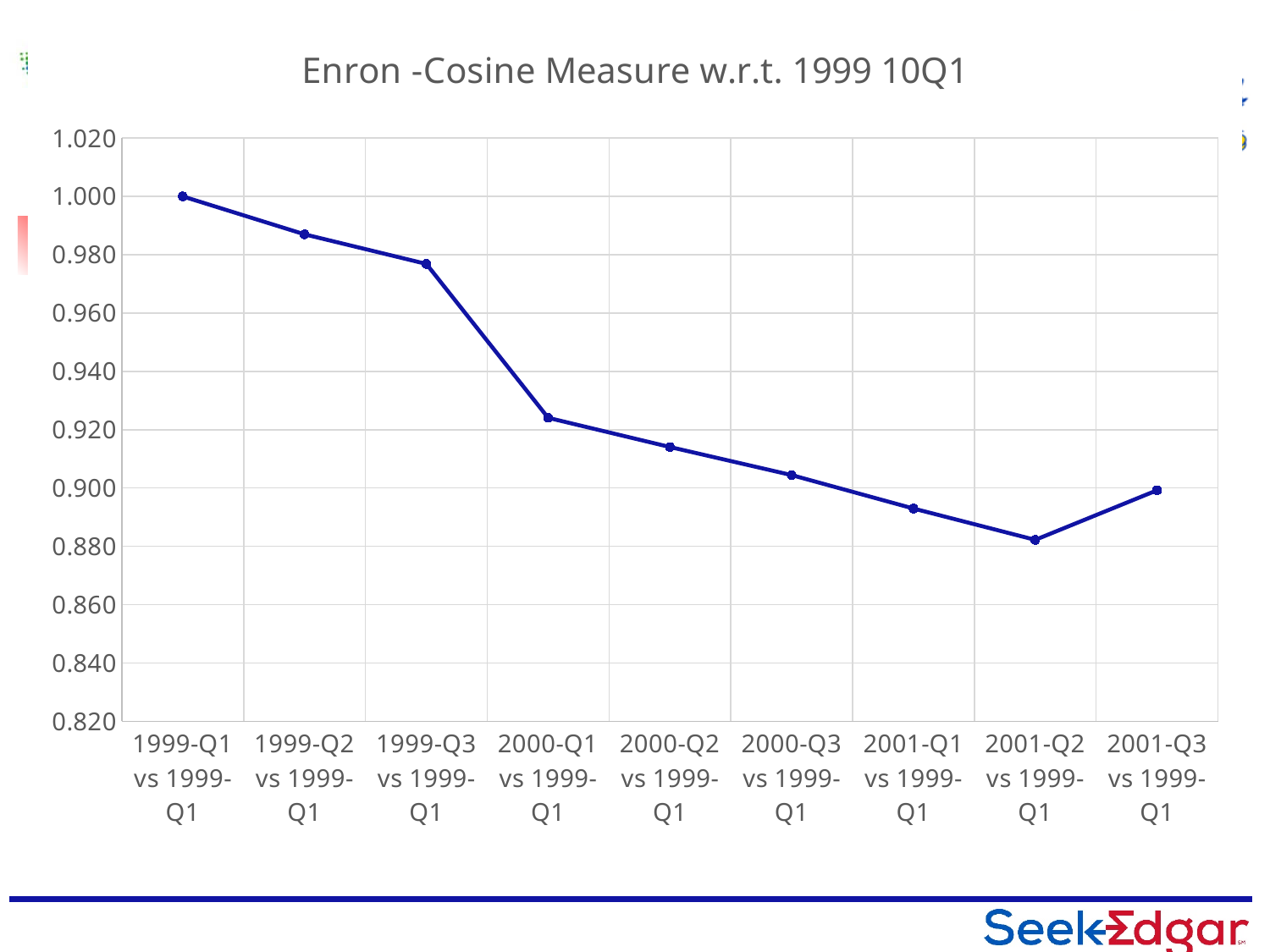
Which category has the lowest value? 2001-Q2 vs 1999-Q1 Is the value for 2000-Q1 vs 1999-Q1 greater or less than 0.940? less Is the value for 1999-Q2 vs 1999-Q1 greater or less than 0.980? greater Is the value for 2000-Q2 vs 1999-Q1 greater or less than 0.920? less What is the title of the chart? Enron -Cosine Measure w.r.t. 1999 10Q1 Do the values generally rise or fall from 1999-Q1 to 2001-Q2 along the x axis? fall What type of chart is shown on the slide? line chart Which category has the highest value? 1999-Q1 vs 1999-Q1 How many data points are plotted on the chart? 9 What is the value for 1999-Q1 vs 1999-Q1? 1.000 Which is larger, the value for 1999-Q3 vs 1999-Q1 or the value for 2000-Q1 vs 1999-Q1? 1999-Q3 vs 1999-Q1